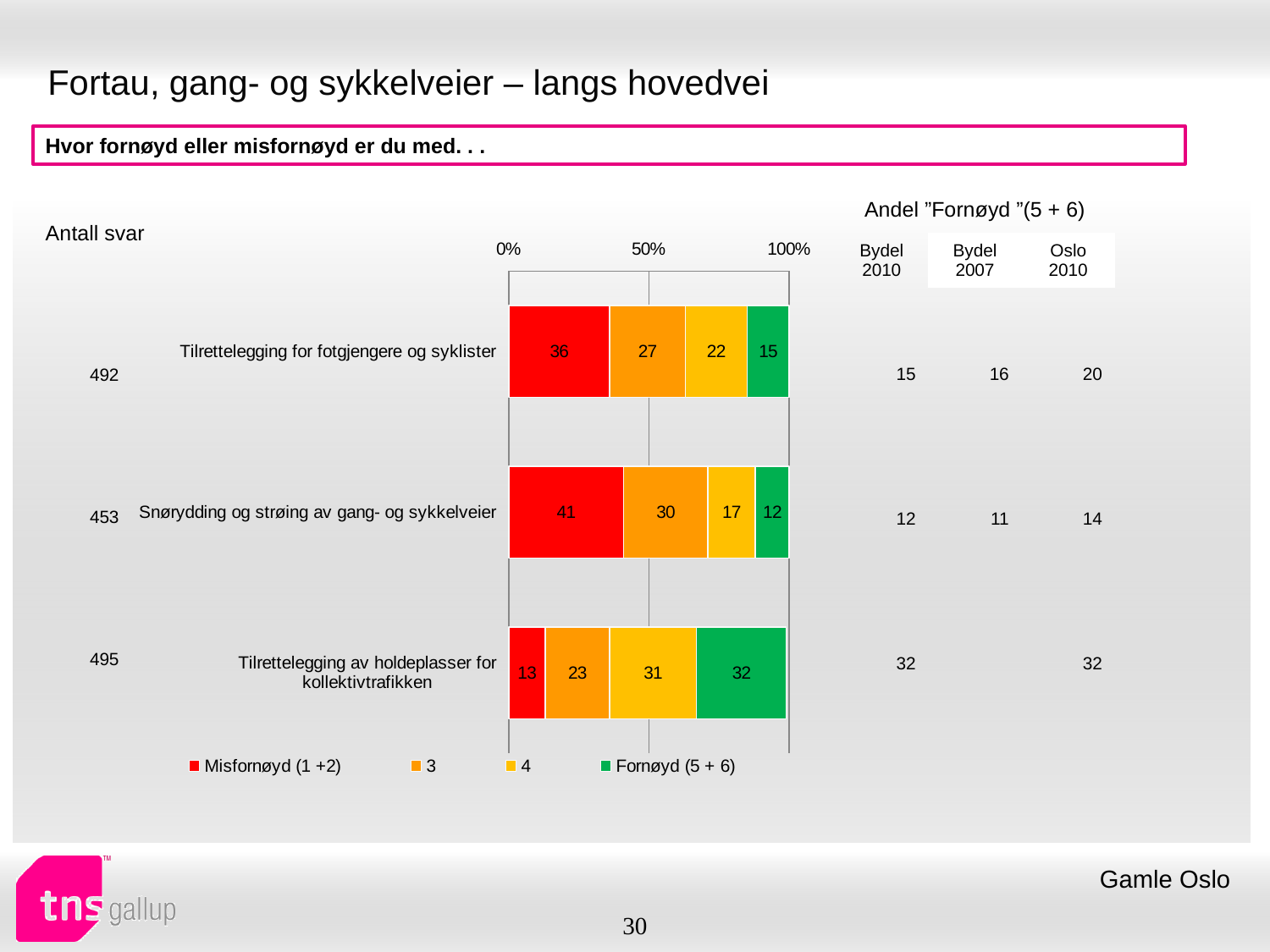
What is the value of "Misfornøyd (1 +2)" for "Snørydding og strøing av gang- og sykkelveier"? 41 How many series does the legend list? 4 Which category has the lowest "Misfornøyd (1 +2)" value? Tilrettelegging av holdeplasser for kollektivtrafikken Which is larger: the "4" value for "Tilrettelegging for fotgjengere og syklister" or for "Snørydding og strøing av gang- og sykkelveier"? Tilrettelegging for fotgjengere og syklister What is the value of series "3" for "Tilrettelegging for fotgjengere og syklister"? 27 Which category has the highest "Fornøyd (5 + 6)" value? Tilrettelegging av holdeplasser for kollektivtrafikken What kind of chart is shown on the slide? Stacked bar chart What is the total of the stacked bar for "Tilrettelegging av holdeplasser for kollektivtrafikken"? 99 How many categories are shown in the chart? 3 What is the difference between the "Misfornøyd (1 +2)" values for "Snørydding og strøing av gang- og sykkelveier" and "Tilrettelegging for fotgjengere og syklister"? 5 What is the value of "Fornøyd (5 + 6)" for "Tilrettelegging av holdeplasser for kollektivtrafikken"? 32 What colour represents "Fornøyd (5 + 6)" in the chart? Green